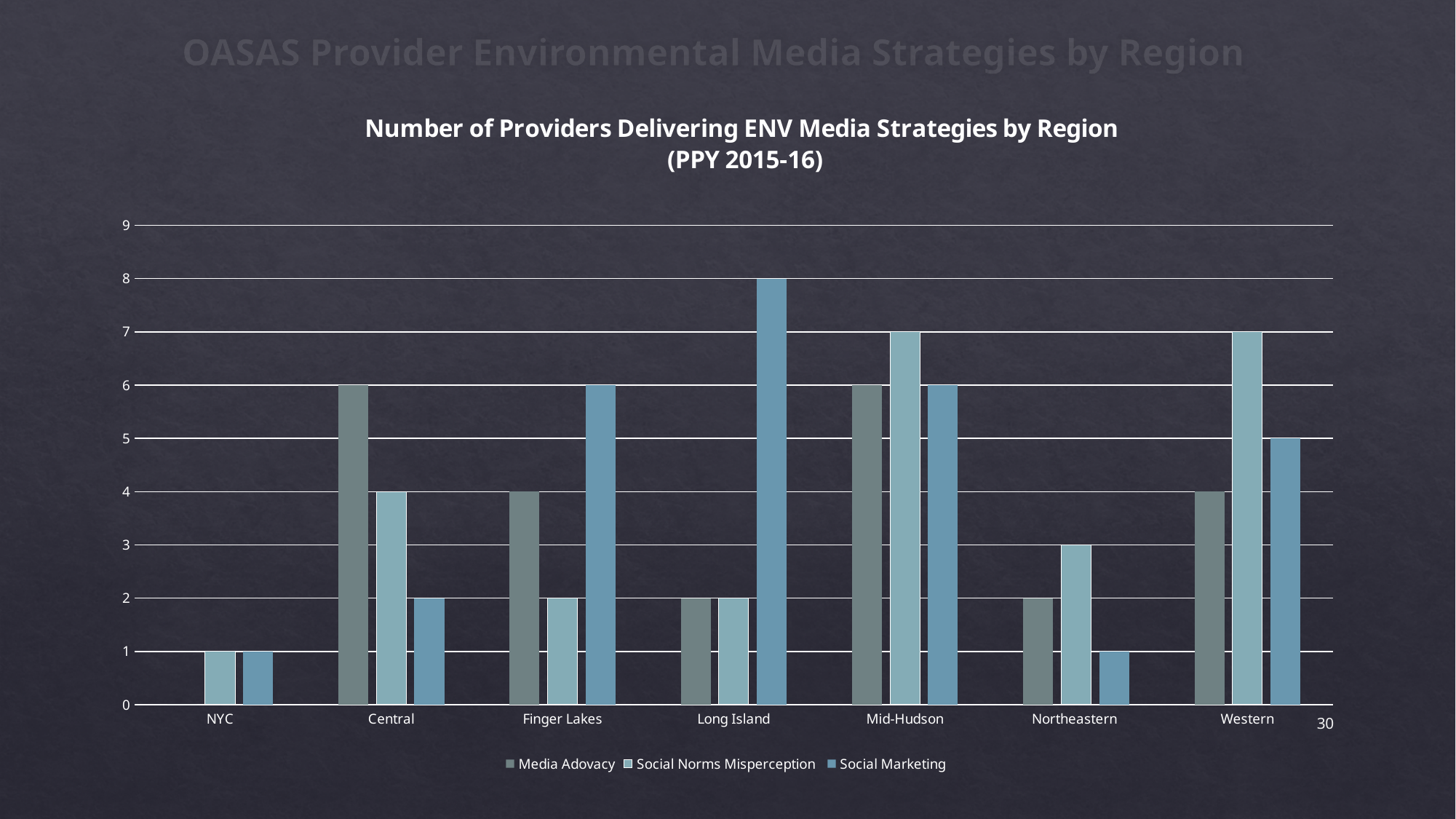
What is the value for Social Norms Misperception in Western? 7 Is the Social Norms Misperception value for Mid-Hudson greater or less than 5? greater Which region has the lowest Social Norms Misperception value? NYC Which is larger, the Media Adovacy value for Mid-Hudson or for Northeastern? Mid-Hudson What is the value for Media Adovacy in Central? 6 What is the title of the chart? Number of Providers Delivering ENV Media Strategies by Region (PPY 2015-16) What kind of chart is shown on the slide? Bar chart How many regions are shown on the x axis? 7 Which region has the highest Social Marketing value? Long Island What is the difference between the Social Marketing values for Finger Lakes and Central? 4 What is the value for Social Marketing in Long Island? 8 How many series does the legend list? 3